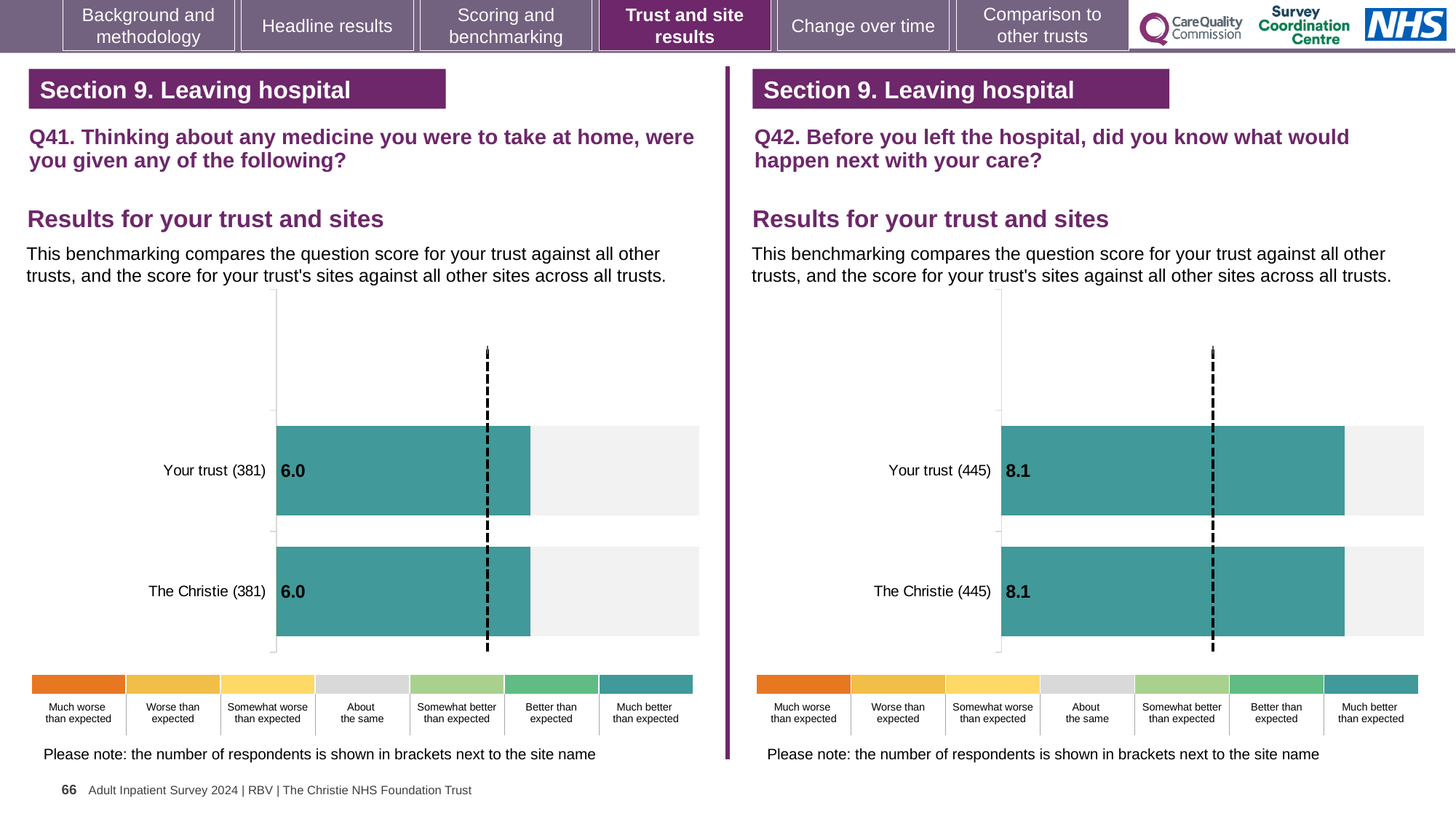
On the left chart (Q41), what is the score for The Christie? 6.0 On the left chart (Q41), what is the score for Your trust? 6.0 On the right chart (Q42), what is the difference between the score for Your trust and the score for The Christie? 0.0 On the right chart (Q42), how many respondents are shown in brackets next to The Christie? 445 On the left chart (Q41), how many respondents are shown in brackets next to Your trust? 381 Is the score for Your trust on the right chart (Q42) larger than the score for Your trust on the left chart (Q41)? Yes On the right chart (Q42), what is the score for Your trust? 8.1 How many bars are plotted on the right chart (Q42)? 2 How many bars are plotted on the left chart (Q41)? 2 What kind of chart is used on the left (Q41)? Bar chart On the left chart (Q41), what is the difference between the score for Your trust and the score for The Christie? 0.0 On the right chart (Q42), what is the score for The Christie? 8.1